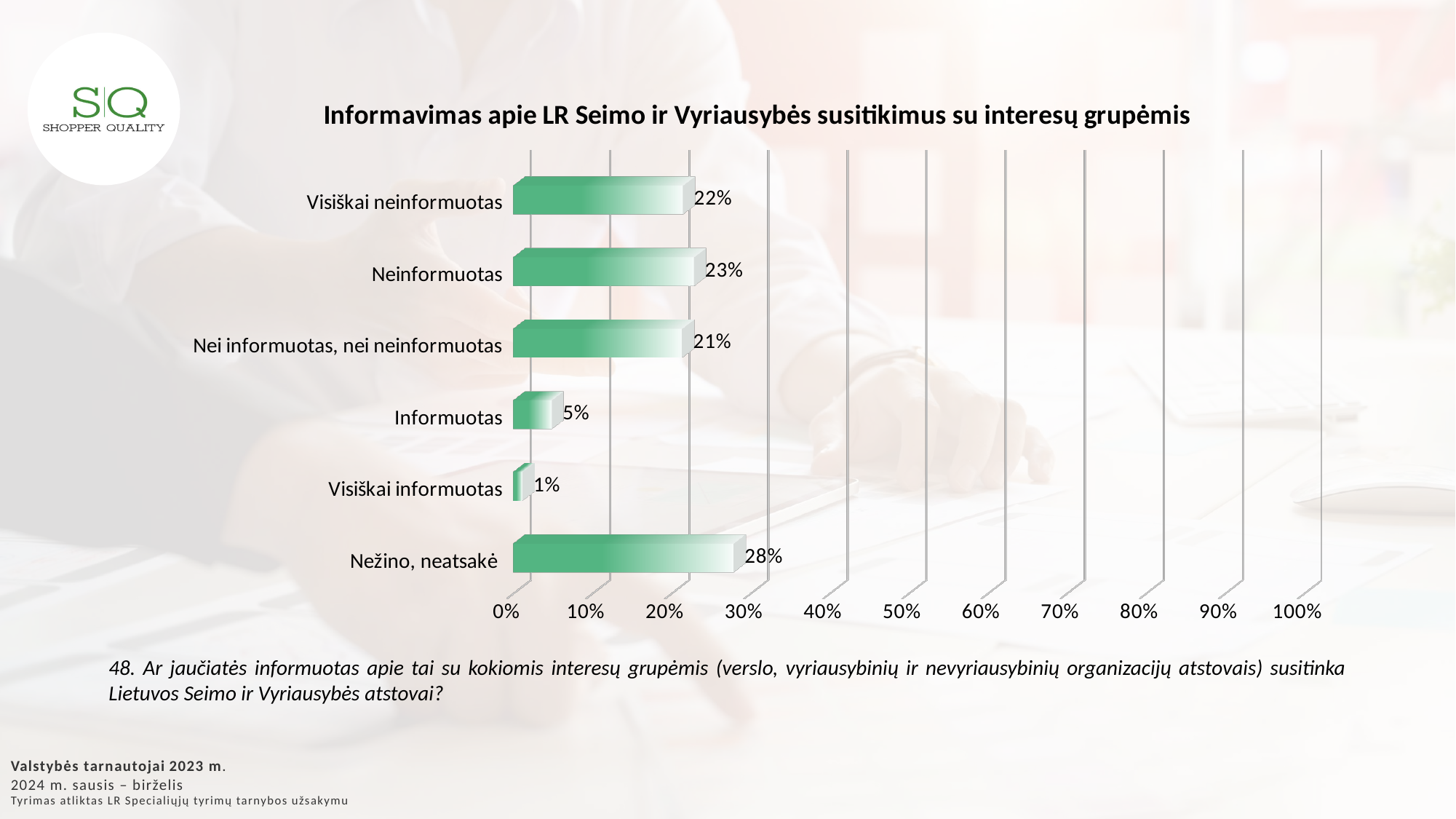
What is the value for "Nei informuotas, nei neinformuotas"? 21% Which is larger, the value for "Neinformuotas" or the value for "Informuotas"? Neinformuotas How many categories are shown in the chart? 6 What is the value for "Visiškai informuotas"? 1% What kind of chart is shown on the slide? Bar chart Is the value for "Nežino, neatsakė" greater or less than 20%? greater Which category has the highest value? Nežino, neatsakė What is the value for "Neinformuotas"? 23% Which category has the lowest value? Visiškai informuotas What is the difference between the values for "Nežino, neatsakė" and "Informuotas"? 23% What is the value for "Visiškai neinformuotas"? 22% What is the value for "Informuotas"? 5%